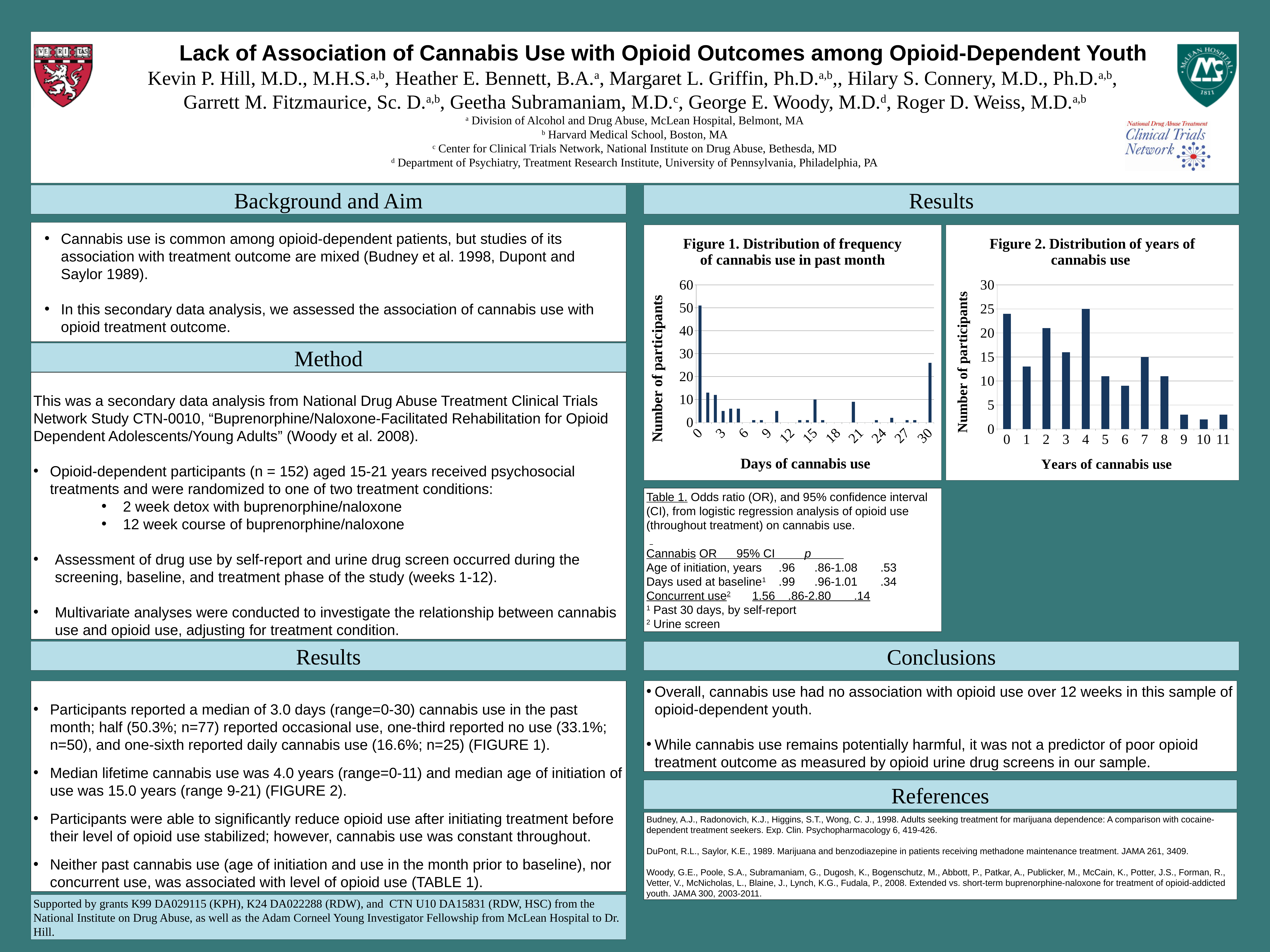
In Figure 1 (Distribution of frequency of cannabis use in past month), is the number of participants at 15 days greater or less than 20? less In Figure 2 (Distribution of years of cannabis use), which has more participants: 4 years or 5 years of cannabis use? 4 years How many years-of-use categories are shown on the x axis of Figure 2 (Distribution of years of cannabis use)? 12 What type of chart is Figure 1 (Distribution of frequency of cannabis use in past month)? bar chart In Figure 2 (Distribution of years of cannabis use), is the number of participants at 0 years greater or less than 20? greater In Figure 1 (Distribution of frequency of cannabis use in past month), is the number of participants at 0 days greater or less than 40? greater What is the y-axis title of Figure 1 (Distribution of frequency of cannabis use in past month)? Number of participants In Figure 1 (Distribution of frequency of cannabis use in past month), which number of days of cannabis use has the highest number of participants? 0 In Figure 2 (Distribution of years of cannabis use), do the values generally rise or fall from 7 years to 10 years? fall In Figure 1 (Distribution of frequency of cannabis use in past month), which has more participants: 30 days or 15 days of cannabis use? 30 days